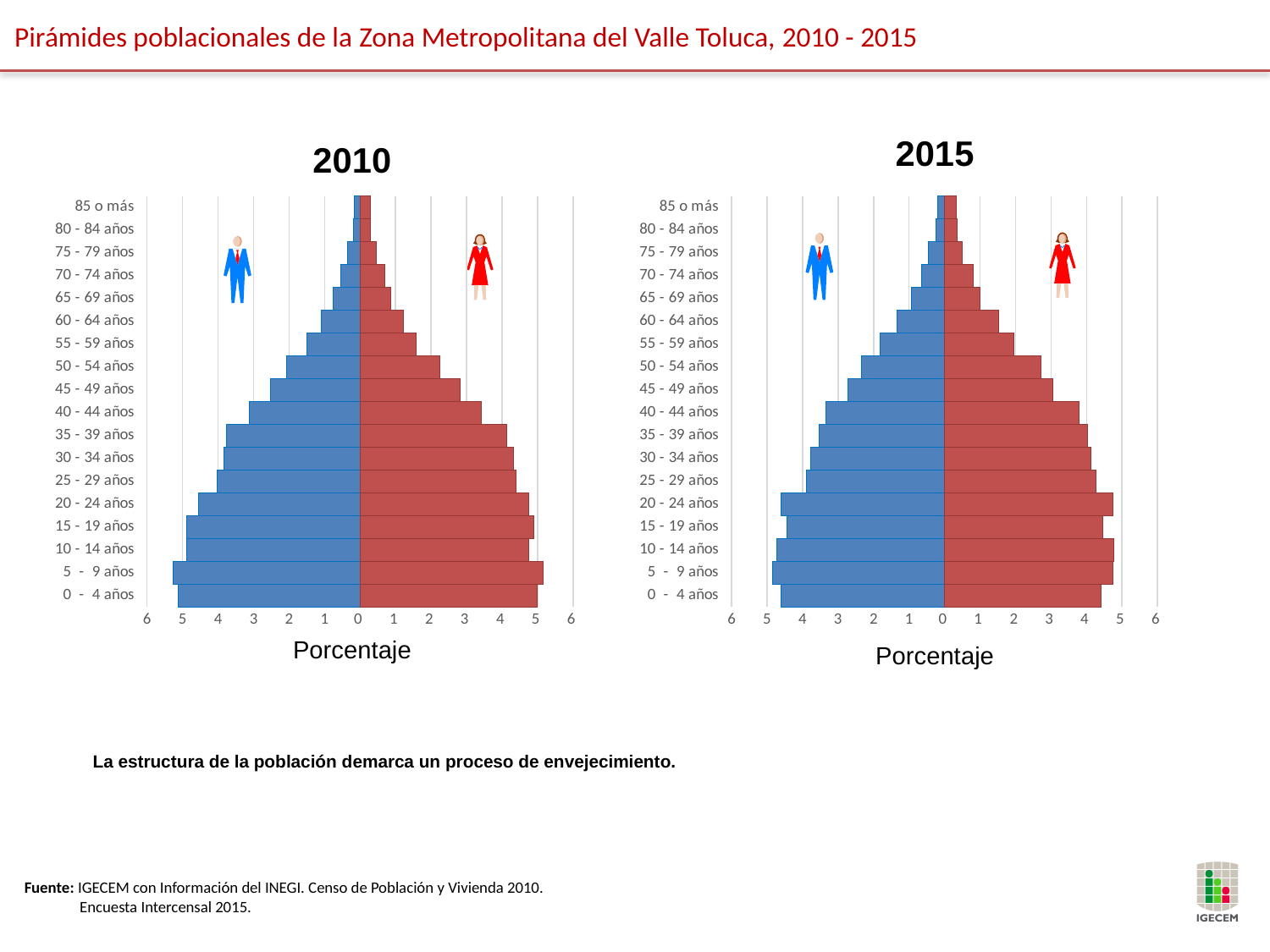
On the 2015 chart, is the value for women aged 0 - 4 años greater or less than 4? greater On the 2015 chart, is the value for men aged 20 - 24 años greater or less than 4? greater On the 2015 chart, is the value for women aged 60 - 64 años greater or less than 1? greater What is the label on the horizontal axis of the 2010 chart? Porcentaje What kind of chart is the 2010 chart? bar chart On the 2010 chart, which age group has the shortest bars? 85 o más On the 2015 chart, which age group has the shortest bars? 85 o más What are the titles of the two charts on the slide? 2010 and 2015 On the 2015 chart, do the bar lengths generally increase or decrease as the age group gets older? decrease How many age groups are shown on the 2015 chart? 18